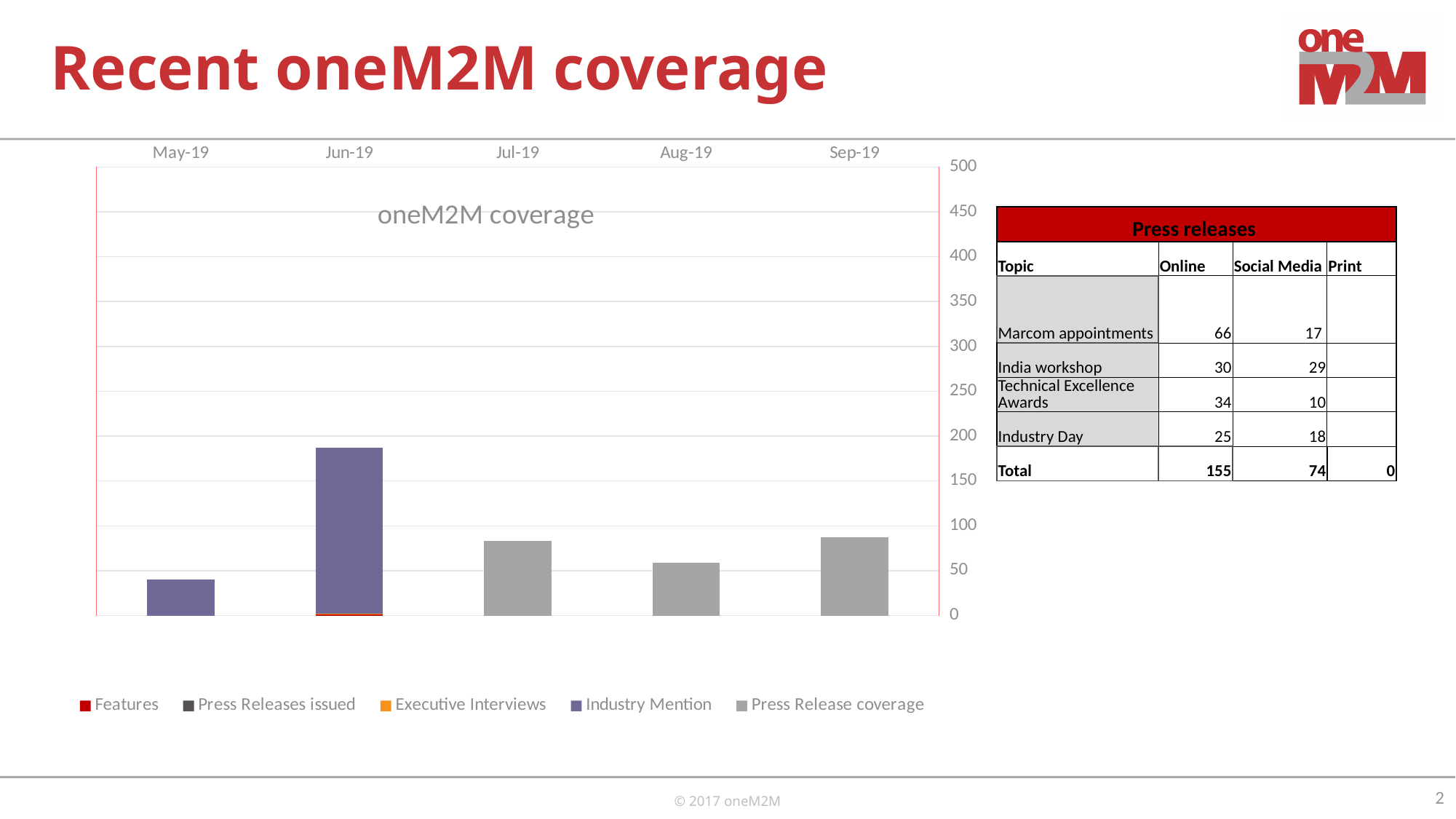
What kind of chart is shown on the slide? bar chart Is the value for Jun-19 greater or less than 150? greater Is the value for May-19 greater or less than 50? less Is the value for Jul-19 greater or less than 100? less What is the title of the chart? oneM2M coverage Which legend series is shown in purple? Industry Mention Which bar is taller, Aug-19 or Sep-19? Sep-19 How many months are shown on the x axis of the chart? 5 How many series does the chart legend list? 5 Which month has the tallest bar in the chart? Jun-19 Which bar is taller, Jun-19 or Jul-19? Jun-19